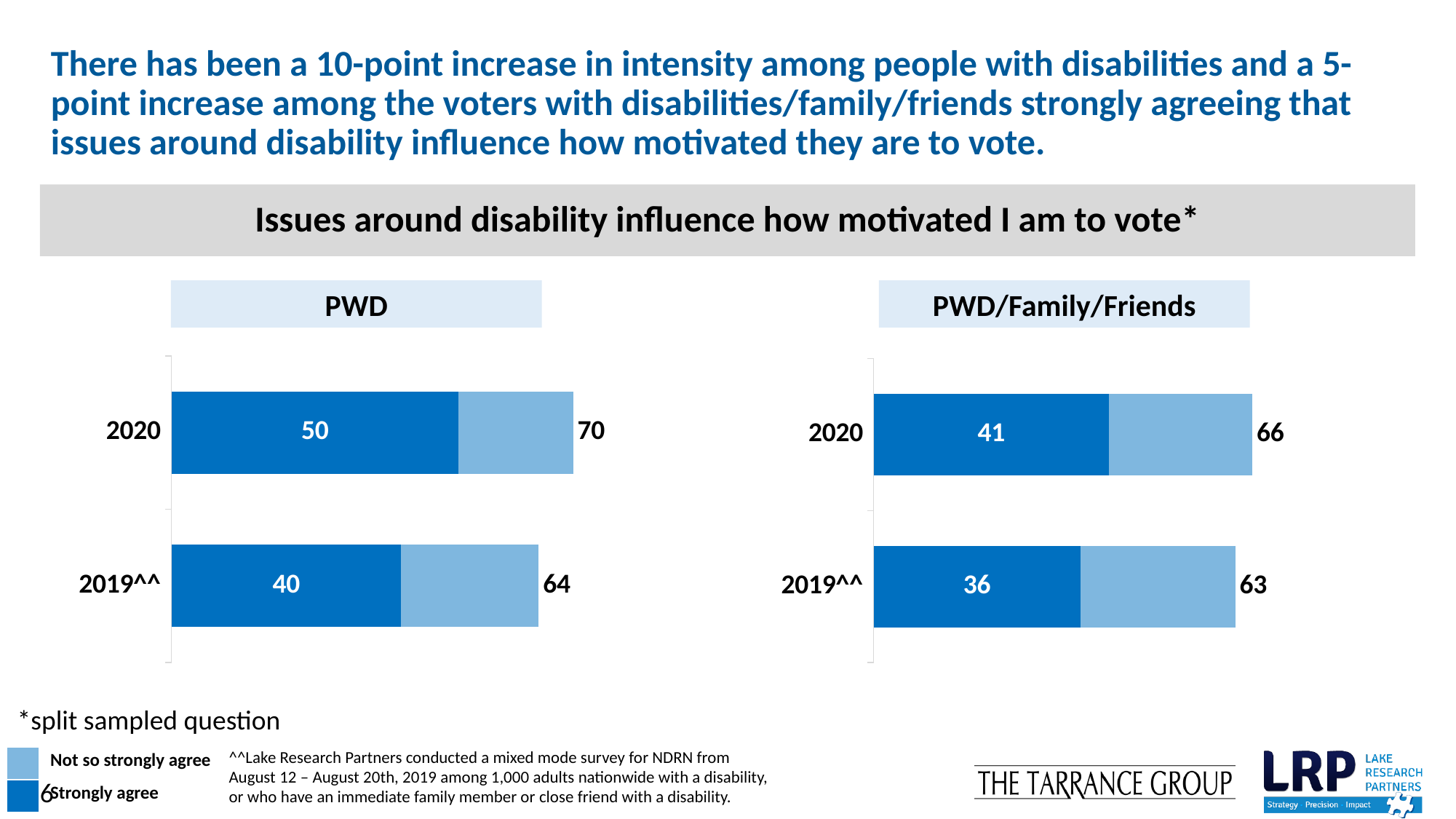
How many series does the legend list? 2 In the PWD chart, which year has the higher 'Strongly agree' value, 2020 or 2019^^? 2020 In the PWD chart, what is the 'Strongly agree' value for 2020? 50 What type of chart is used for the PWD data? Stacked bar chart In the PWD chart, what is the total value shown at the end of the 2019^^ bar? 64 How many years (categories) are shown in the PWD/Family/Friends chart? 2 What is the title shown above the two charts? Issues around disability influence how motivated I am to vote* In the PWD/Family/Friends chart, what is the difference between the 2020 total (66) and the 2019^^ total (63)? 3 In the PWD/Family/Friends chart, what is the total value shown at the end of the 2020 bar? 66 In the PWD/Family/Friends chart, what is the 'Strongly agree' value for 2019^^? 36 Which chart shows the higher 'Strongly agree' value for 2020, PWD or PWD/Family/Friends? PWD In the PWD chart, by how much did the 'Strongly agree' value increase from 2019^^ to 2020? 10